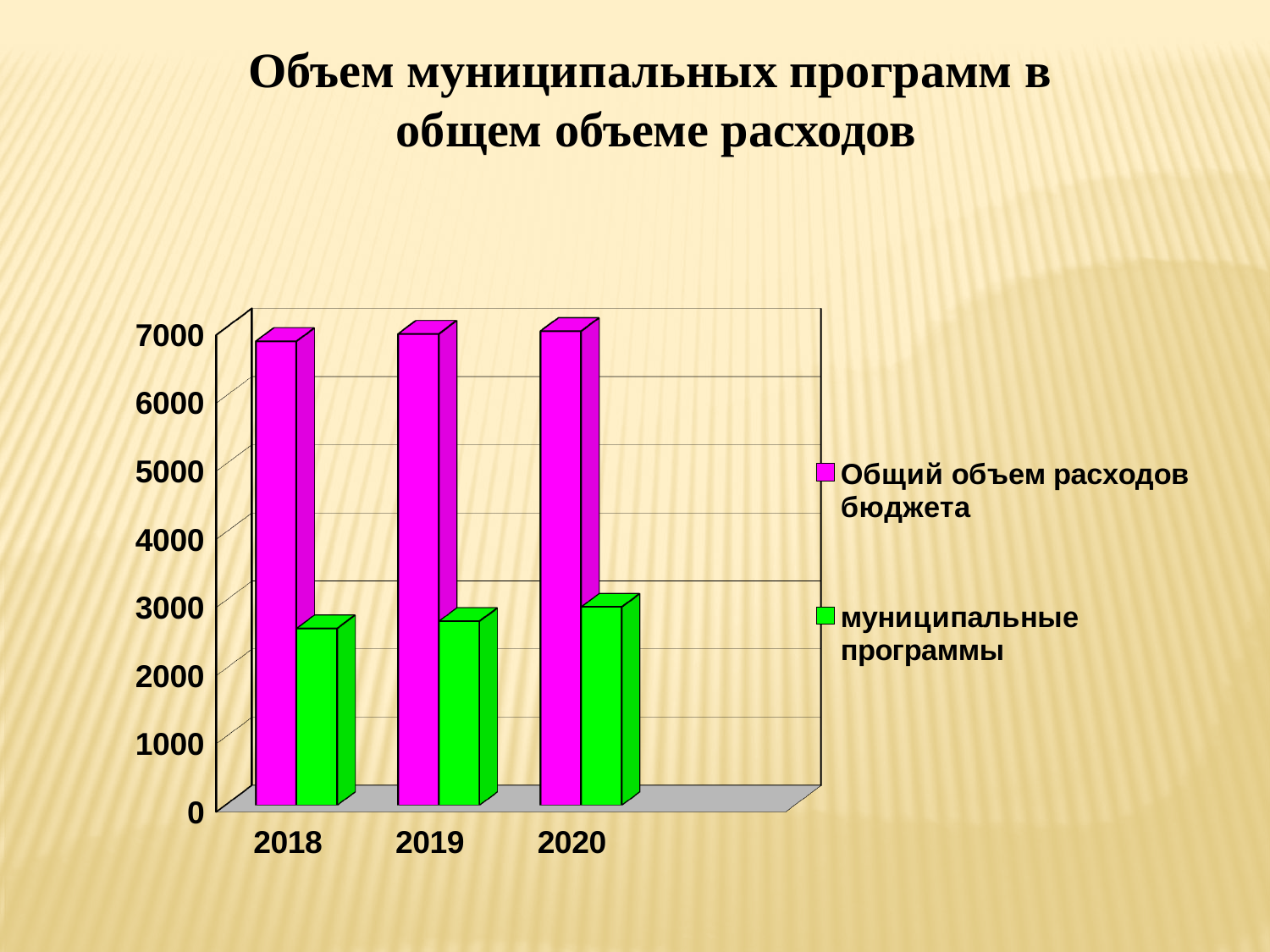
What is the title of the chart? Объем муниципальных программ в общем объеме расходов Is the value for муниципальные программы in 2018 greater or less than 3000? less What kind of chart is shown on the slide? Bar chart Do the values for муниципальные программы rise or fall from 2018 to 2020? rise Is the value for муниципальные программы in 2019 greater or less than 4000? less In 2020, which is larger: Общий объем расходов бюджета or муниципальные программы? Общий объем расходов бюджета Which series is shown in green? муниципальные программы Is the value for муниципальные программы in 2020 greater or less than 2000? greater In which year is the value for муниципальные программы the highest? 2020 How many series does the legend list? 2 How many years are shown on the x axis? 3